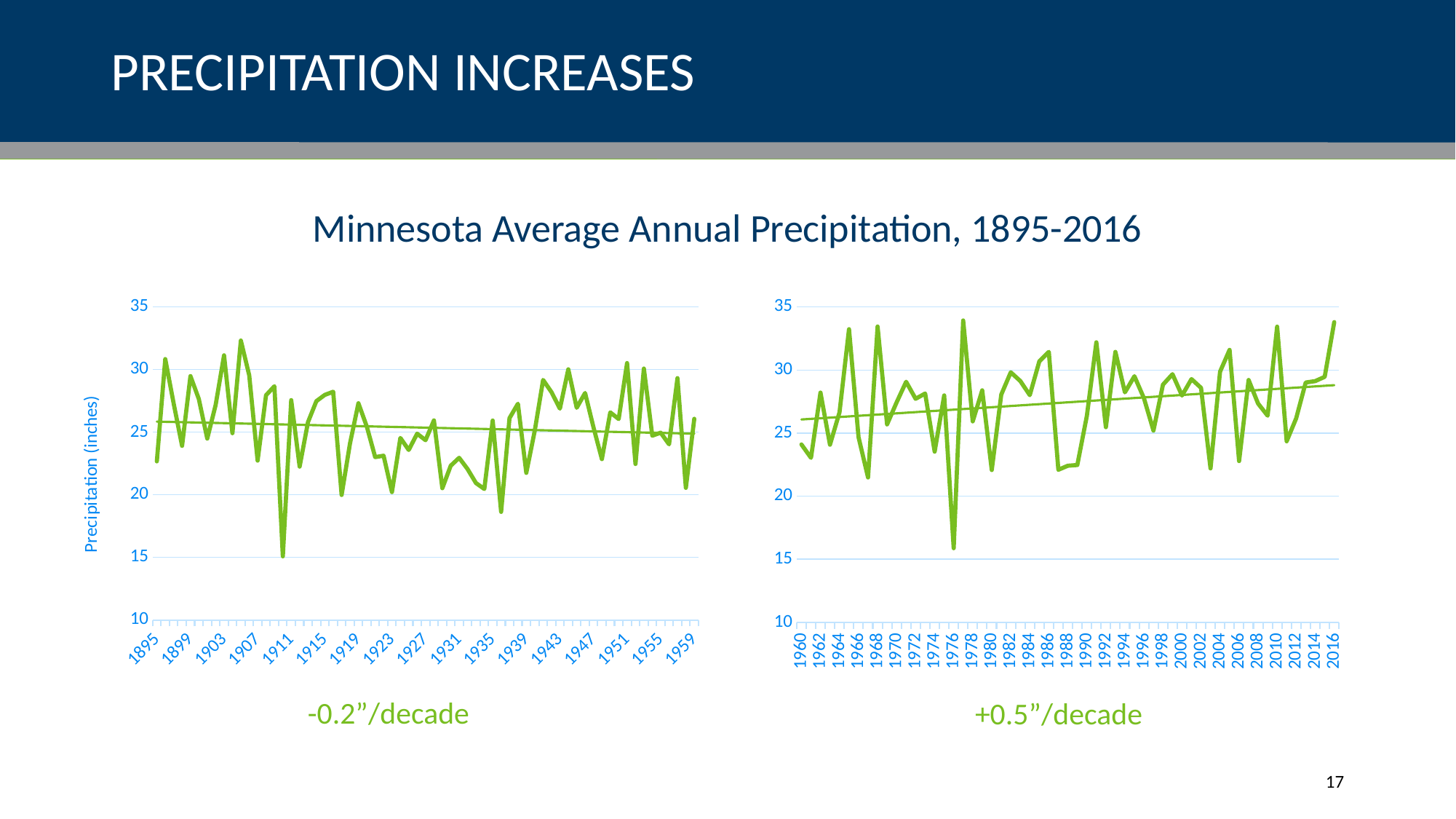
In the left chart (1895-1959), is the value for 1895 greater or less than 25? less What kind of chart is used on the left side of the slide? line chart In the right chart (1960-2016), is the value for 2016 greater or less than 30? greater In the right chart (1960-2016), does the trend line rise or fall across the years? rise What is the label on the vertical axis of the left chart? Precipitation (inches) In the left chart (1895-1959), does the trend line rise or fall across the years? fall In the left chart (1895-1959), which year has the lowest precipitation? 1910 In the right chart (1960-2016), is the value for 1976 greater or less than 20? less What is the title shown above the two charts? Minnesota Average Annual Precipitation, 1895-2016 In the right chart (1960-2016), which year has the larger value, 1960 or 2016? 2016 In the right chart (1960-2016), which year has the lowest precipitation? 1976